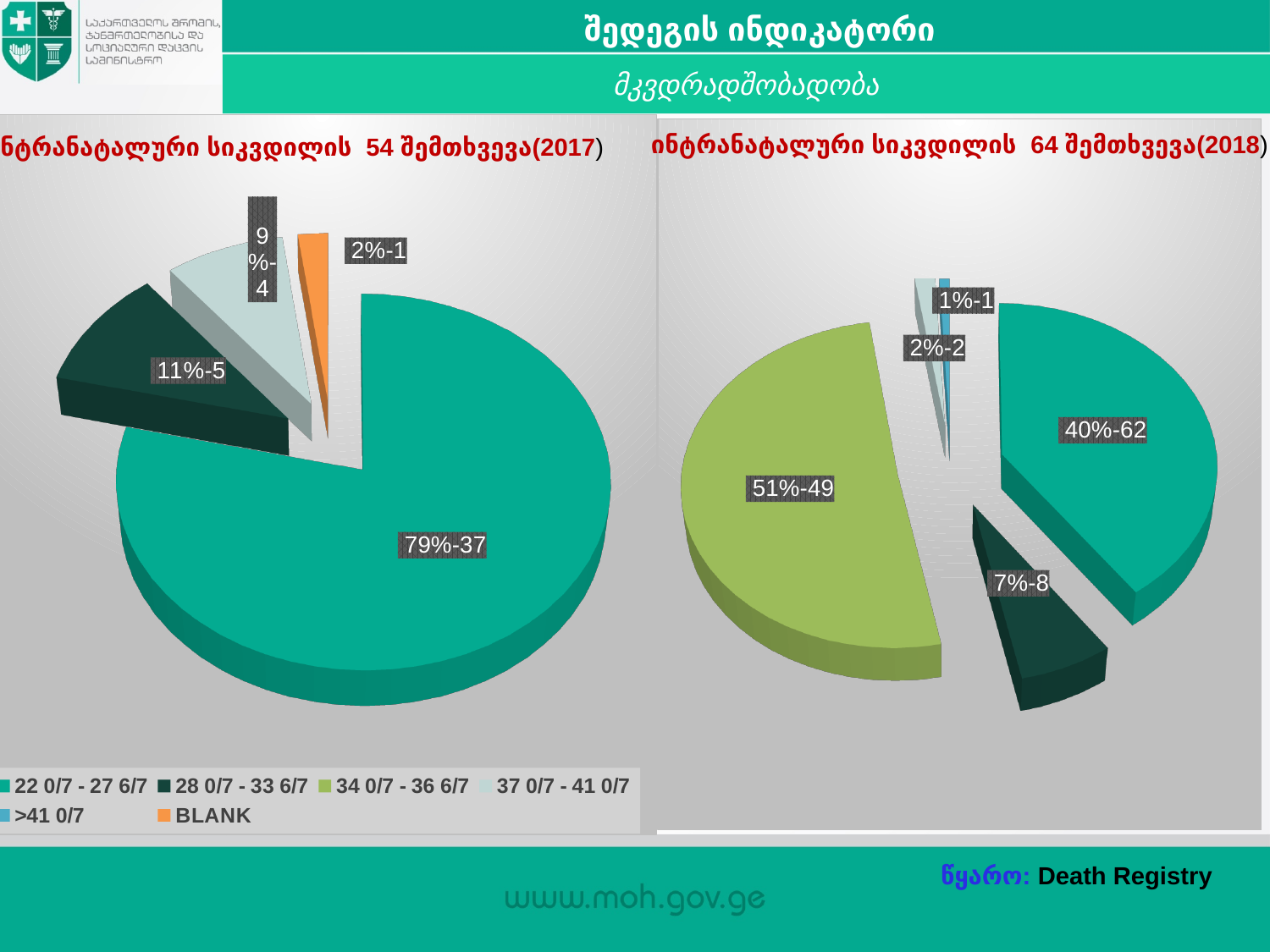
In the left (2017) pie chart, what share of the pie does the 37 0/7 - 41 0/7 slice represent? 9% In the left (2017) pie chart, what label is shown on the BLANK (orange) slice? 2%-1 In the right (2018) pie chart, which is larger: the 34 0/7 - 36 6/7 slice or the 22 0/7 - 27 6/7 slice? 34 0/7 - 36 6/7 In the left (2017) pie chart, which legend category does the largest slice (79%-37) belong to? 22 0/7 - 27 6/7 In the right (2018) pie chart, what label is shown on the dark green 28 0/7 - 33 6/7 slice? 7%-8 In the right (2018) pie chart, which slice is the smallest? >41 0/7 (1%-1) How many categories does the legend at the bottom of the slide list? 6 In the left (2017) pie chart, what label is shown on the dark green 28 0/7 - 33 6/7 slice? 11%-5 What kind of chart is used on the left (2017) side of the slide? Pie chart In the right (2018) pie chart, what label is shown on the light green 34 0/7 - 36 6/7 slice? 51%-49 In the left (2017) pie chart, what label is shown on the largest slice? 79%-37 How many slices does the left (2017) pie chart have? 4